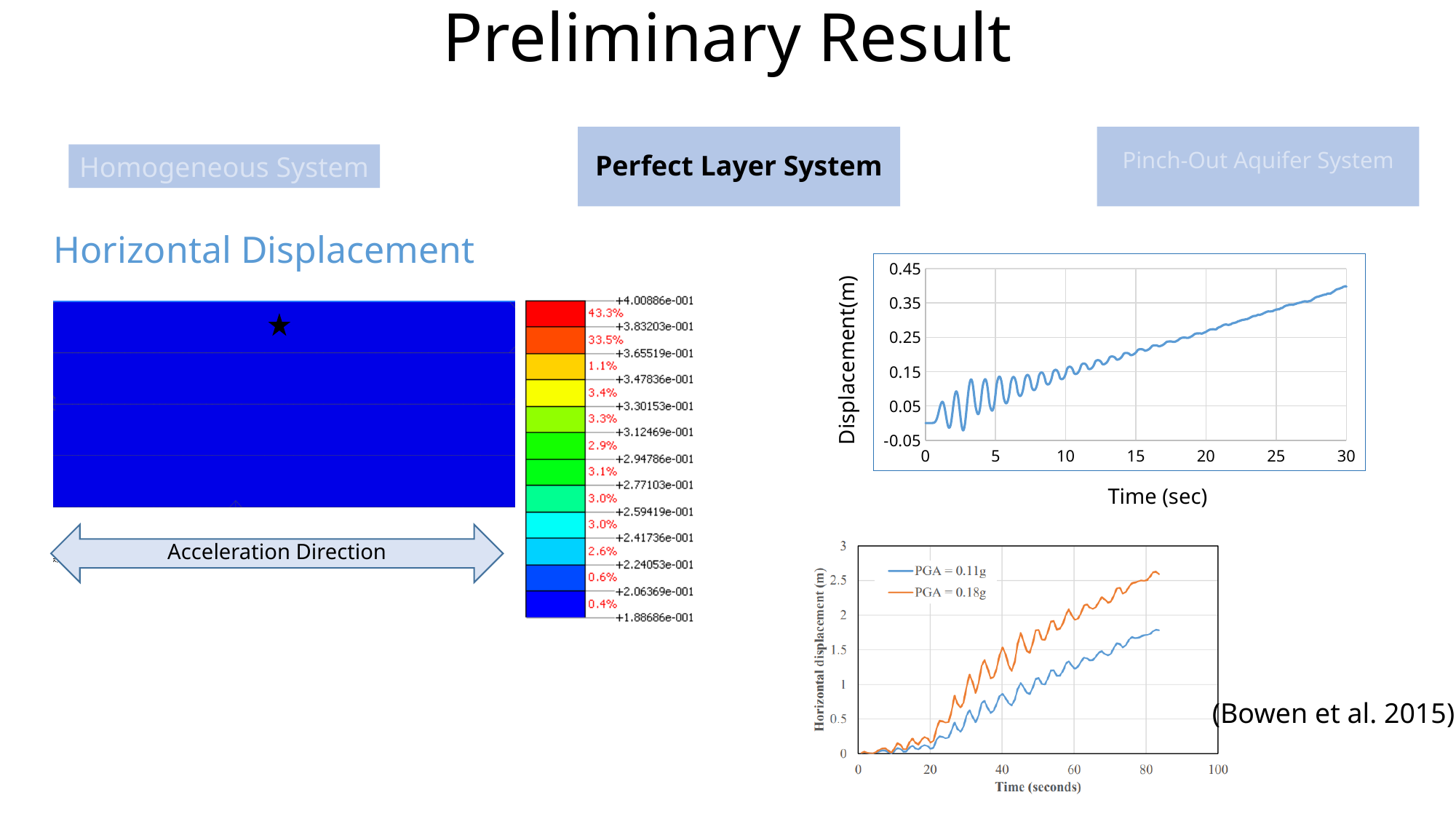
What kind of chart is the lower right chart (Bowen et al. 2015)? Line chart How many series does the legend of the lower right chart (Bowen et al. 2015) list? 2 What kind of chart is the upper right chart of Displacement(m) against Time (sec)? Line chart In the lower right chart (Bowen et al. 2015), does the horizontal displacement for PGA = 0.11g rise or fall over time? Rise In the upper right chart (Displacement(m) vs Time (sec)), what is the highest value shown on the y axis? 0.45 In the upper right chart (Displacement(m) vs Time (sec)), is the displacement at 15 seconds greater or less than 0.25? less In the lower right chart (Bowen et al. 2015), is the horizontal displacement for PGA = 0.18g at 80 seconds greater or less than 2? greater In the lower right chart (Bowen et al. 2015), which series has the larger horizontal displacement at 80 seconds, PGA = 0.11g or PGA = 0.18g? PGA = 0.18g In the upper right chart (Displacement(m) vs Time (sec)), is the displacement at 30 seconds greater or less than 0.35? greater In the upper right chart (Displacement(m) vs Time (sec)), does the displacement generally rise or fall as time increases? Rise What are the two series named in the legend of the lower right chart (Bowen et al. 2015)? PGA = 0.11g and PGA = 0.18g